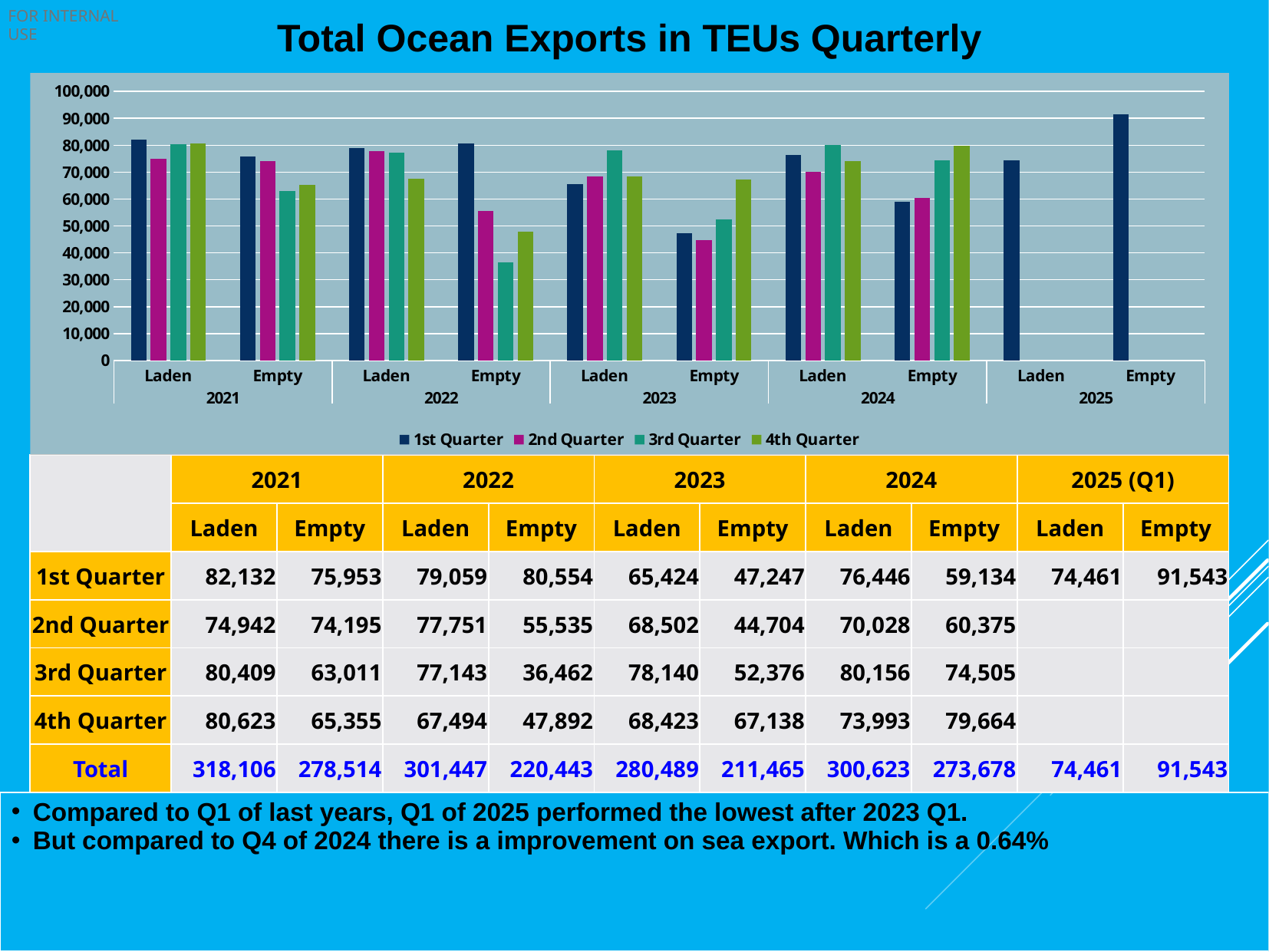
Do the Empty values for 2024 rise or fall from the 1st Quarter to the 4th Quarter? Rise Which bar in the chart is the highest overall? 1st Quarter, Empty 2025 What is the 1st Quarter value for Empty in 2025? 91,543 Which is larger in 2023: the 3rd Quarter Laden value or the 3rd Quarter Empty value? 3rd Quarter Laden What is the difference between the 1st Quarter Empty and 1st Quarter Laden values in 2025? 17,082 How many series does the chart legend list? 4 Which bar in the chart is the lowest overall? 3rd Quarter, Empty 2022 What kind of chart is shown on the slide? Bar chart What is the title of the chart? Total Ocean Exports in TEUs Quarterly Is the 3rd Quarter value for Empty in 2022 greater or less than 40,000? less What is the 1st Quarter value for Laden in 2021? 82,132 What is the 3rd Quarter value for Empty in 2022? 36,462